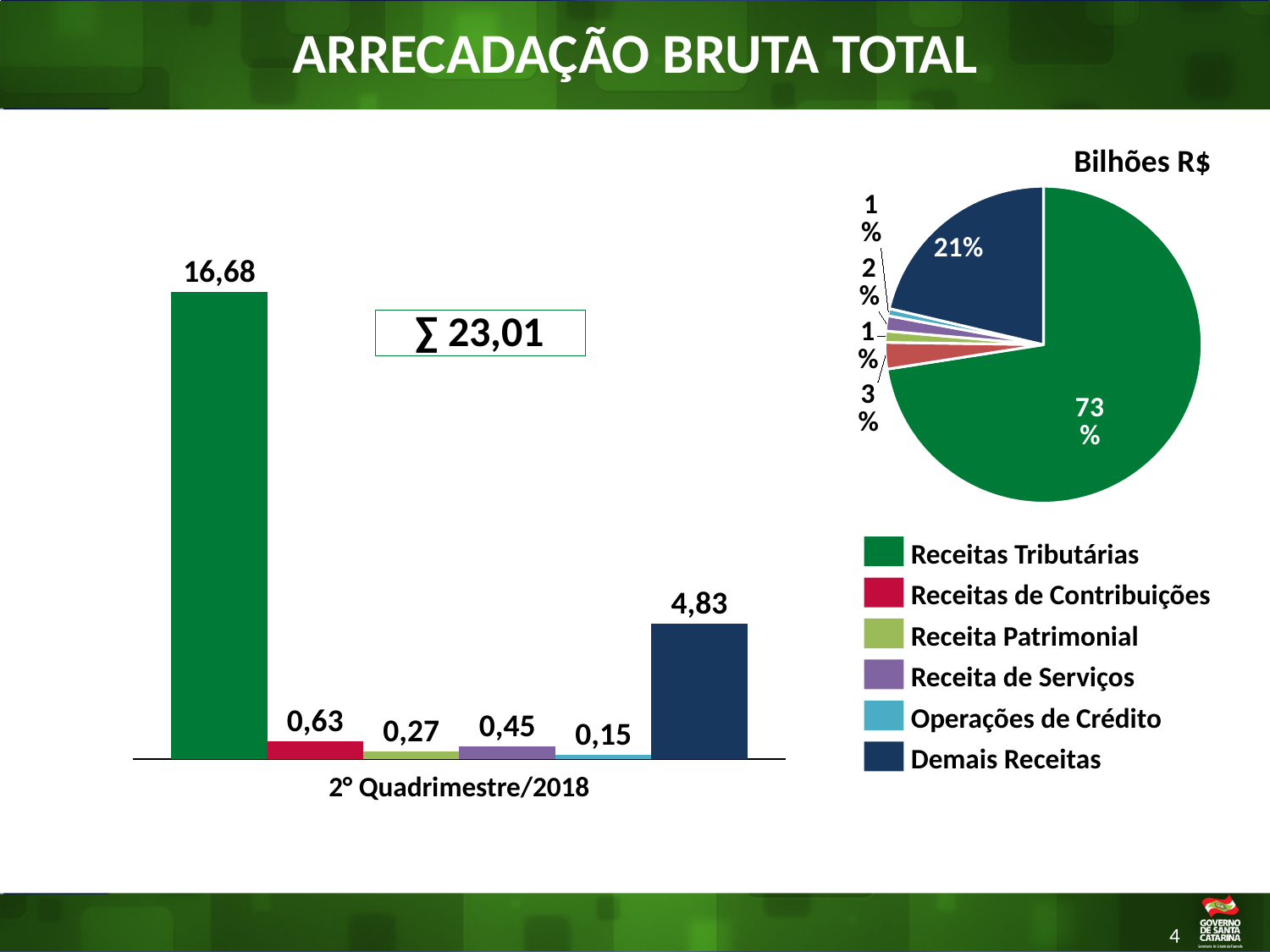
In the bar chart on the left, which series has the highest value? Receitas Tributárias In the pie chart on the right, what share does Demais Receitas have? 21% In the bar chart on the left, what is the value for Operações de Crédito? 0,15 What kind of chart is the chart on the left of the slide? bar chart How many series does the legend list? 6 In the pie chart on the right, what share does Receitas Tributárias have? 73% In the bar chart on the left, which series has the lowest value? Operações de Crédito In the bar chart on the left, what is the difference between Receitas Tributárias and Demais Receitas? 11,85 In the bar chart on the left, which is larger: Receitas de Contribuições or Receita de Serviços? Receitas de Contribuições What total (∑) is shown on the bar chart on the left? 23,01 In the bar chart on the left, what is the value for Demais Receitas? 4,83 In the bar chart on the left, what is the value for Receitas Tributárias? 16,68